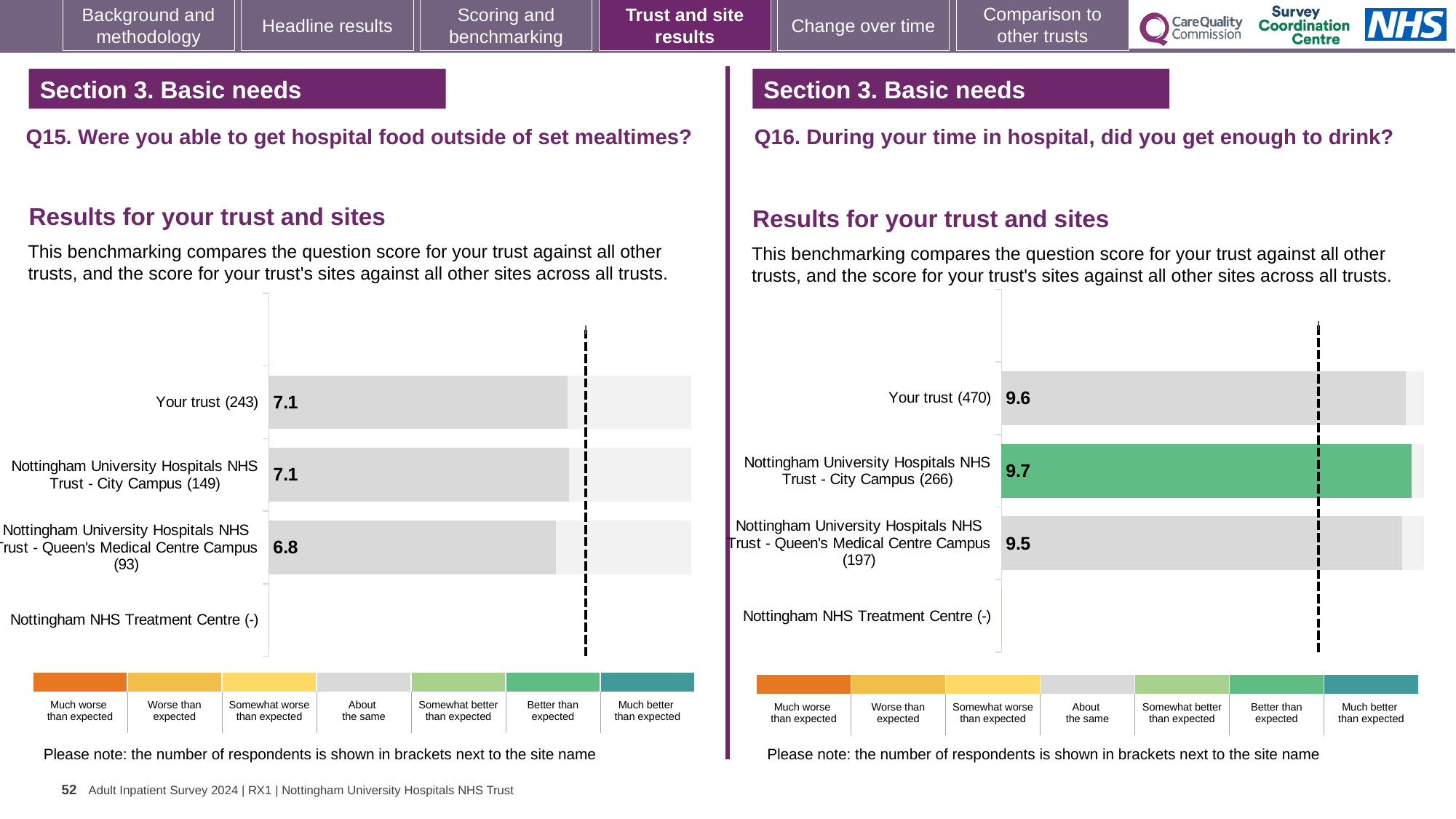
In the Q15 chart on the left, which labelled bar has the lowest score? Nottingham University Hospitals NHS Trust - Queen's Medical Centre Campus (93) In the Q15 chart on the left, what is the score for Nottingham University Hospitals NHS Trust - Queen's Medical Centre Campus (93)? 6.8 In the Q16 chart on the right, which is larger: the score for Your trust or the score for Queen's Medical Centre Campus? Your trust In the Q16 chart on the right, what is the score for Your trust (470)? 9.6 How many site/trust categories are listed on the y axis of the Q15 chart on the left? 4 In the Q16 chart on the right, which site has the highest score? Nottingham University Hospitals NHS Trust - City Campus (266) What type of chart is used for the Q16 results on the right? Bar chart In the Q16 chart on the right, which bar is coloured green rather than grey? Nottingham University Hospitals NHS Trust - City Campus (266) In the Q16 chart on the right, what is the score for Nottingham University Hospitals NHS Trust - City Campus (266)? 9.7 In the Q15 chart on the left, what is the difference between the City Campus score and the Queen's Medical Centre Campus score? 0.3 In the Q15 chart on the left, what is the score for Your trust (243)? 7.1 In the Q16 chart on the right, what is the difference between the City Campus score and the Queen's Medical Centre Campus score? 0.2